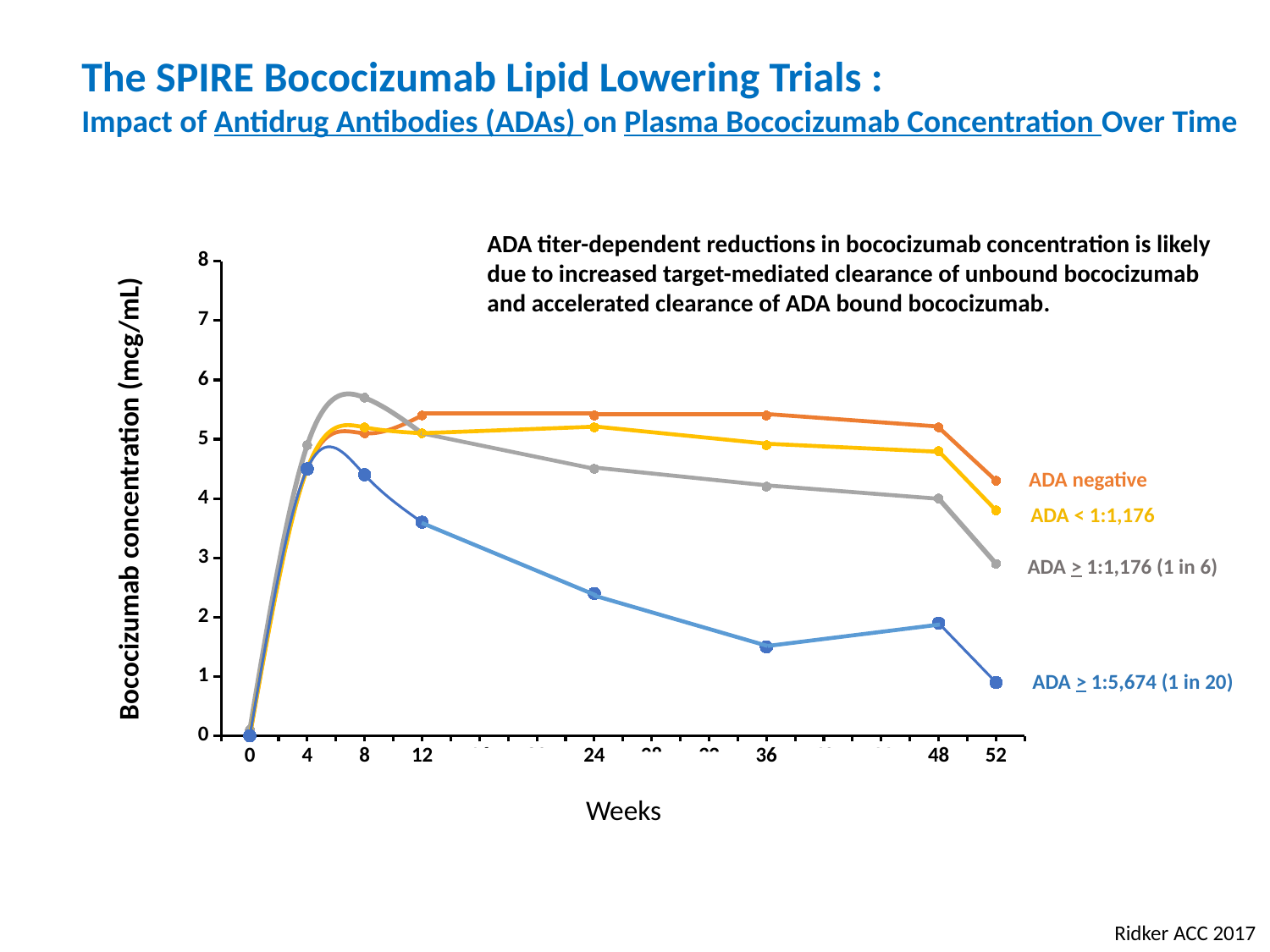
Which series has the lowest bococizumab concentration at week 52? ADA > 1:5,674 (1 in 20) How many series (ADA groups) are plotted on the chart? 4 What is the label of the y axis? Bococizumab concentration (mcg/mL) Is the value for ADA negative at week 52 greater or less than 4? greater At week 8, which is larger: the value for ADA > 1:1,176 (1 in 6) or the value for ADA > 1:5,674 (1 in 20)? ADA > 1:1,176 (1 in 6) Does the ADA > 1:5,674 (1 in 20) series rise or fall between week 8 and week 36? fall What kind of chart is shown on the slide? Line chart Which series has the highest bococizumab concentration at week 52? ADA negative What is the label of the x axis? Weeks Is the value for ADA > 1:5,674 (1 in 20) at week 36 greater or less than 2? less Is the value for ADA > 1:5,674 (1 in 20) at week 12 greater or less than 3? greater